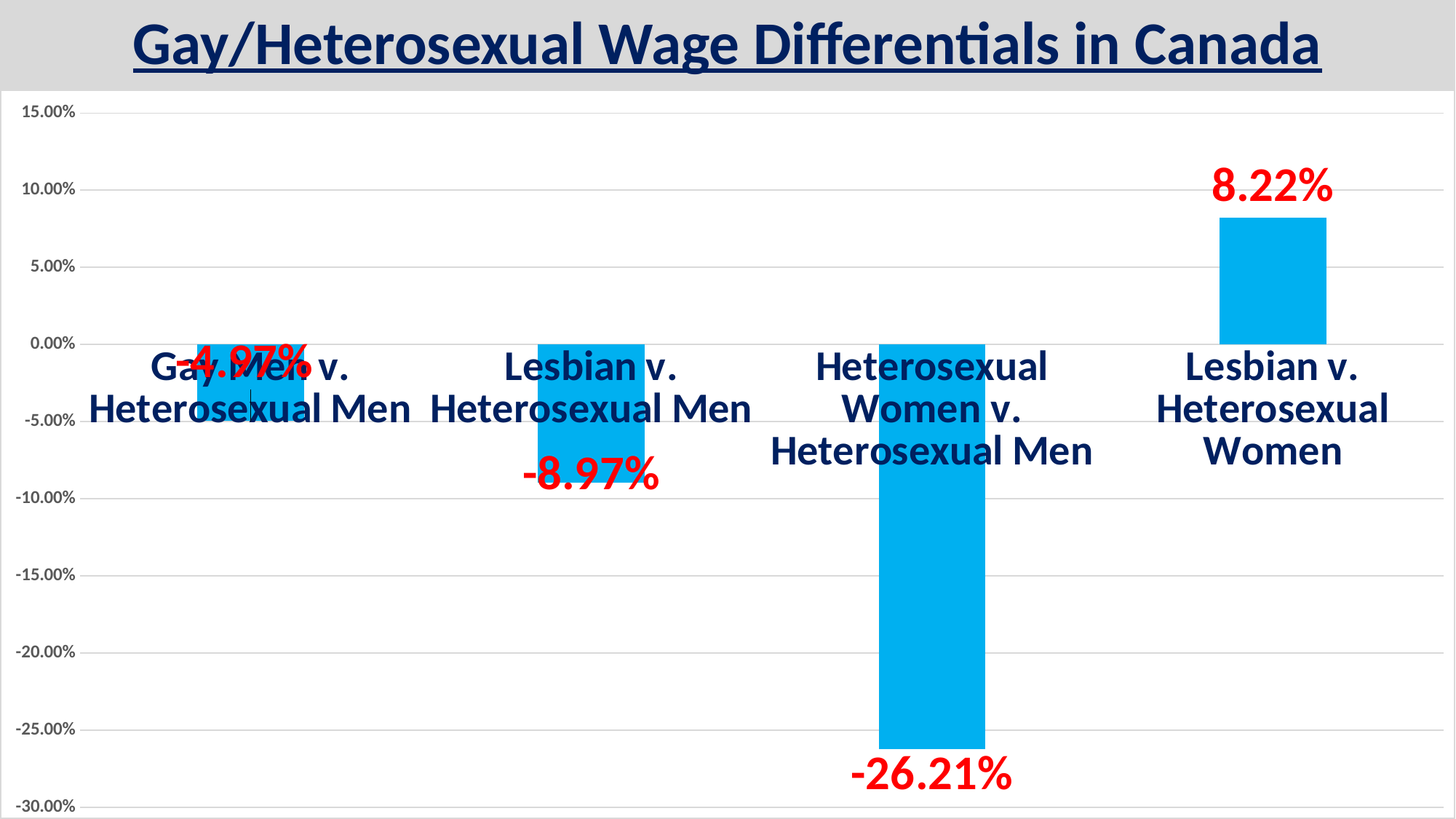
How many categories are shown in the chart? 4 Is the value for Heterosexual Women v. Heterosexual Men greater or less than -25.00%? less Which category has the highest value? Lesbian v. Heterosexual Women What is the value for Lesbian v. Heterosexual Men? -8.97% What is the value for Lesbian v. Heterosexual Women? 8.22% Which is larger, the value for Gay Men v. Heterosexual Men or the value for Lesbian v. Heterosexual Men? Gay Men v. Heterosexual Men What is the value for Gay Men v. Heterosexual Men? -4.97% What is the value for Heterosexual Women v. Heterosexual Men? -26.21% What is the title of the chart? Gay/Heterosexual Wage Differentials in Canada Which category has the lowest value? Heterosexual Women v. Heterosexual Men What kind of chart is shown on the slide? Bar chart What is the difference between the values for Lesbian v. Heterosexual Women and Lesbian v. Heterosexual Men? 17.19%